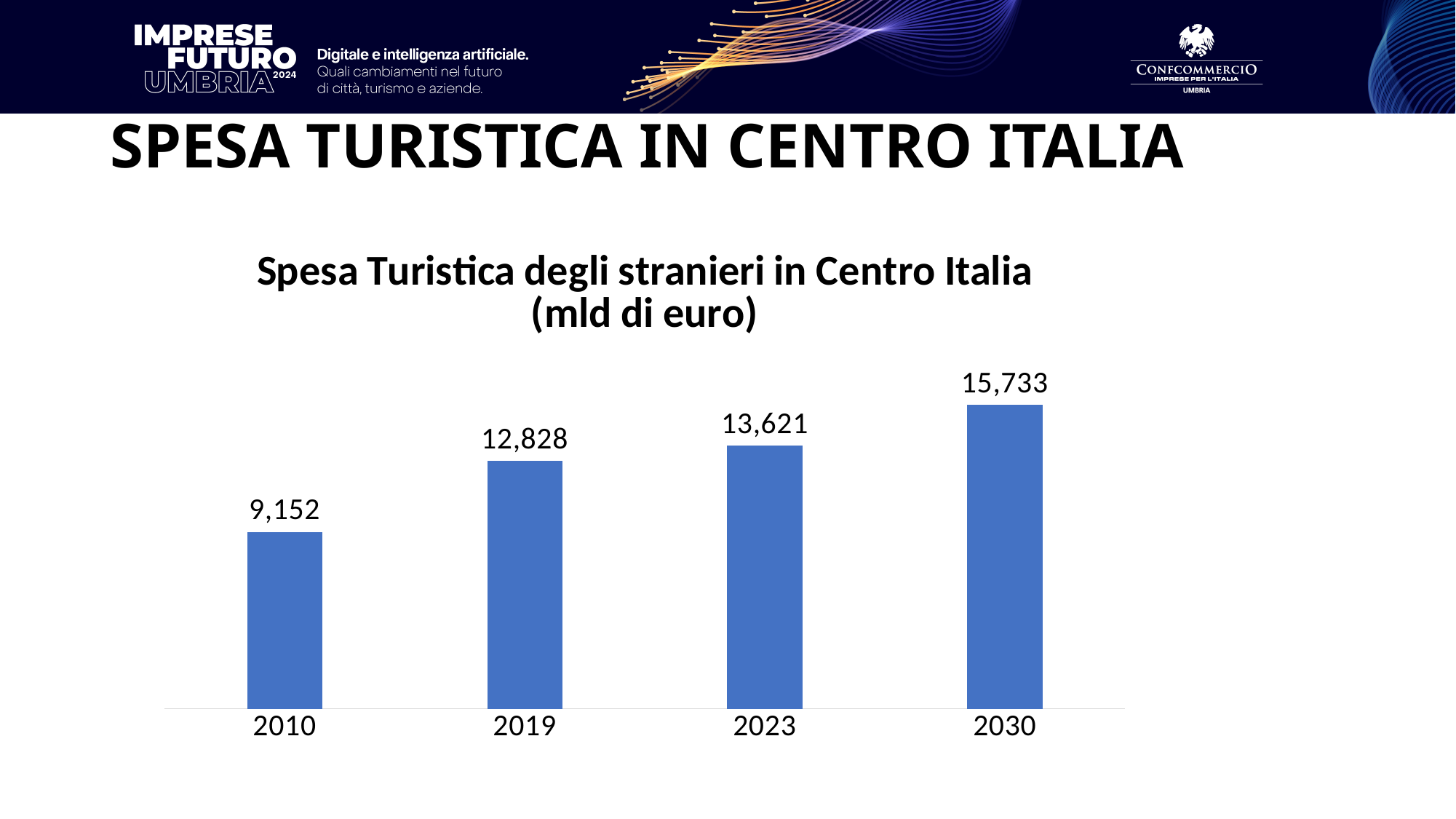
What is the value for 2030? 15,733 Which year has the lowest value? 2010 Do the values rise or fall from 2010 to 2030? Rise Which is larger, the value for 2019 or the value for 2023? 2023 What is the difference between the values for 2030 and 2010? 6,581 What kind of chart is shown on the slide? Bar chart Which year has the highest value? 2030 What is the value for 2023? 13,621 What is the difference between the values for 2023 and 2019? 0,793 What is the value for 2019? 12,828 How many bars are shown in the chart? 4 What is the value for 2010? 9,152